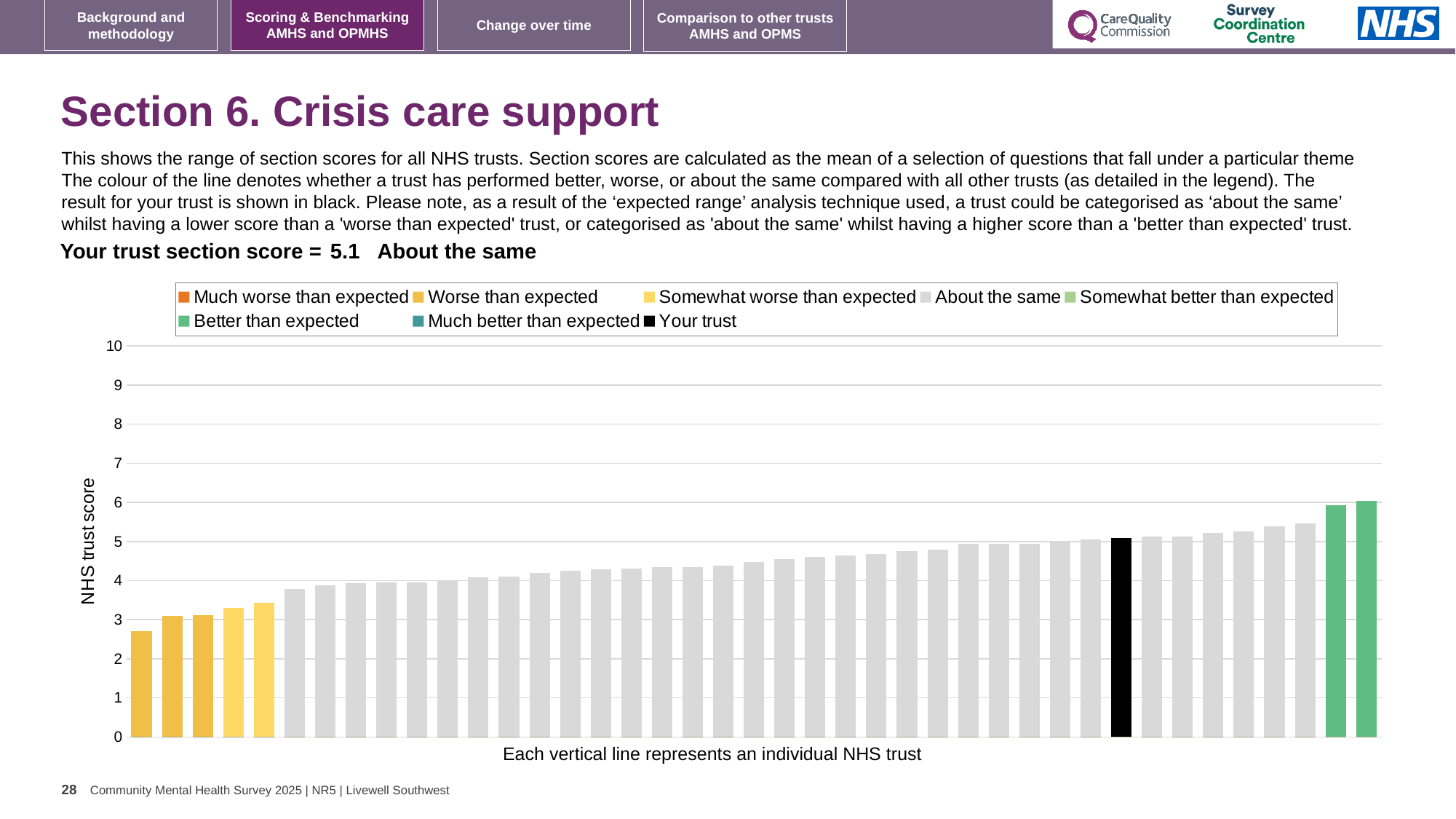
What is the section score for your trust shown on the slide? 5.1 What kind of chart is shown on the slide? bar chart Is the value of the black 'Your trust' bar greater or less than 4? greater What is the label on the vertical axis of the chart? NHS trust score How many bars are coloured as 'Better than expected' (green)? 2 How many entries does the chart legend list? 8 Which category is your trust placed in for this section? About the same How many bars are coloured as 'Worse than expected' (dark yellow)? 3 Do the bar values rise or fall from left to right across the chart? rise Which is taller, the black 'Your trust' bar or the rightmost green bar? the rightmost green bar Is the value of the leftmost (lowest) bar greater or less than 3? less Is the value of the rightmost (highest) bar greater or less than 5? greater